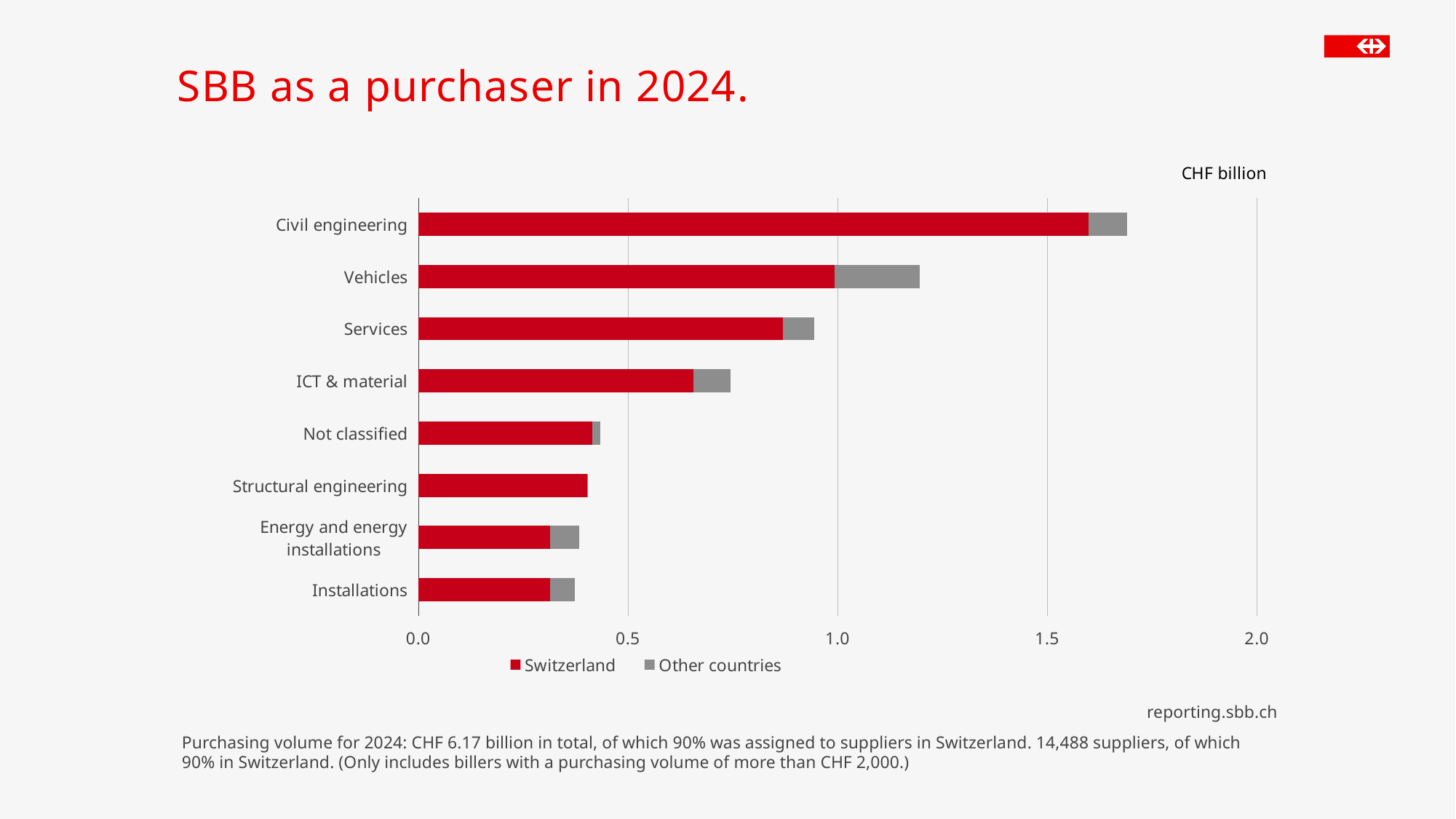
Is the total value for ICT & material greater or less than 0.5? greater Is the total value for Structural engineering greater or less than 0.5? less What are the two series listed in the legend? Switzerland and Other countries What kind of chart is shown on the slide? bar chart Which has a larger total value, Vehicles or Services? Vehicles Is the total value for Services greater or less than 1.0? less How many categories are shown on the chart? 8 How many series does the legend list? 2 What unit is the x axis measured in? CHF billion Which category has the highest total purchasing volume? Civil engineering